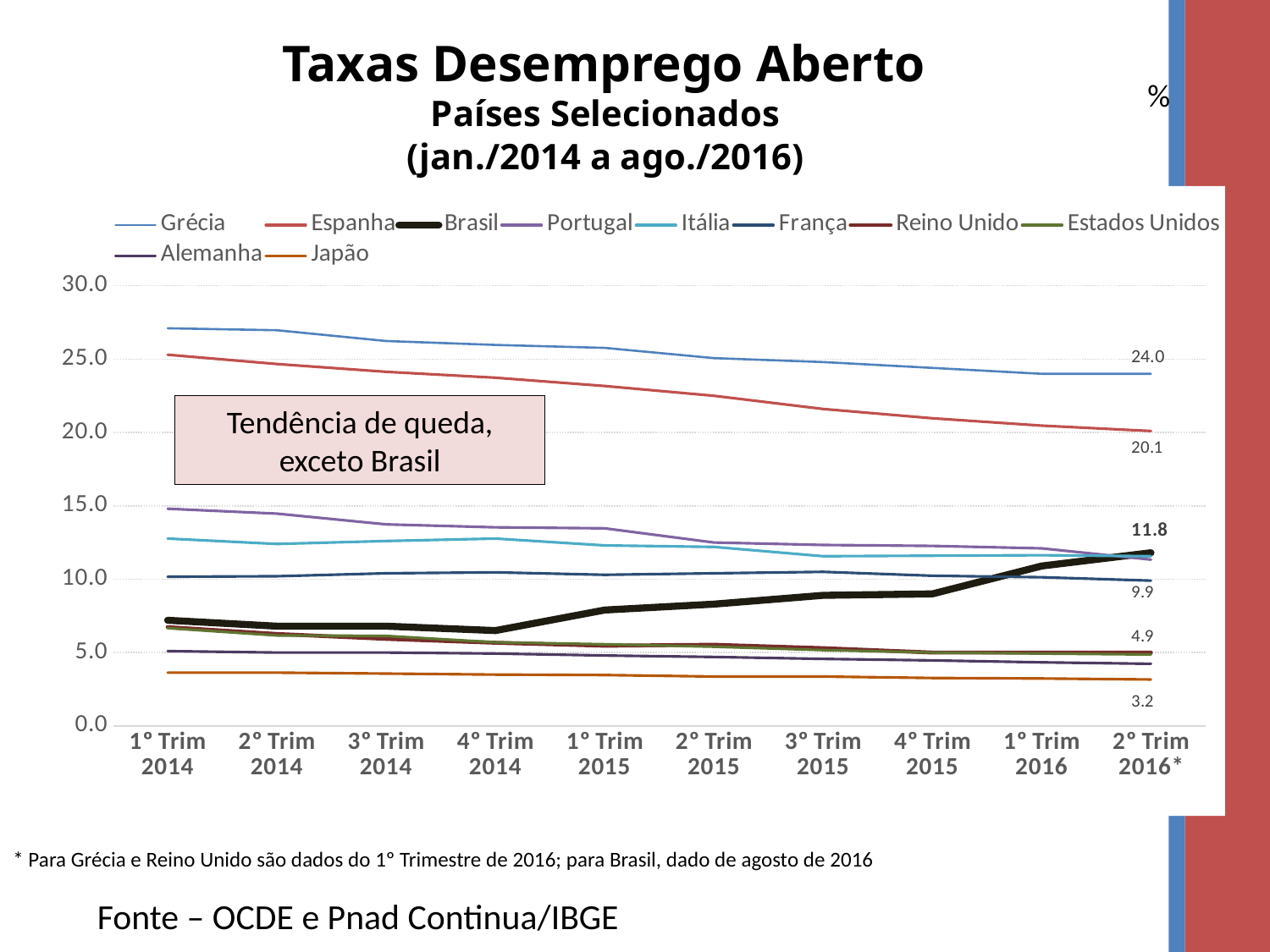
What is the unemployment rate for Grécia at 2° Trim 2016*? 24.0 Does the Brasil line rise or fall from 1° Trim 2014 to 2° Trim 2016*? rises What is the unemployment rate for Brasil at 2° Trim 2016*? 11.8 Is the value for Grécia at 1° Trim 2014 greater or less than 25.0? greater What is the difference between the Grécia and Espanha rates at 2° Trim 2016*? 3.9 What is the unemployment rate for Japão at 2° Trim 2016*? 3.2 What kind of chart is shown on the slide? line chart Which country has the highest unemployment rate at 2° Trim 2016*? Grécia What is the unemployment rate for Espanha at 2° Trim 2016*? 20.1 How many series does the legend list? 10 Which country has the lowest unemployment rate at 2° Trim 2016*? Japão How many quarters are shown along the x axis? 10